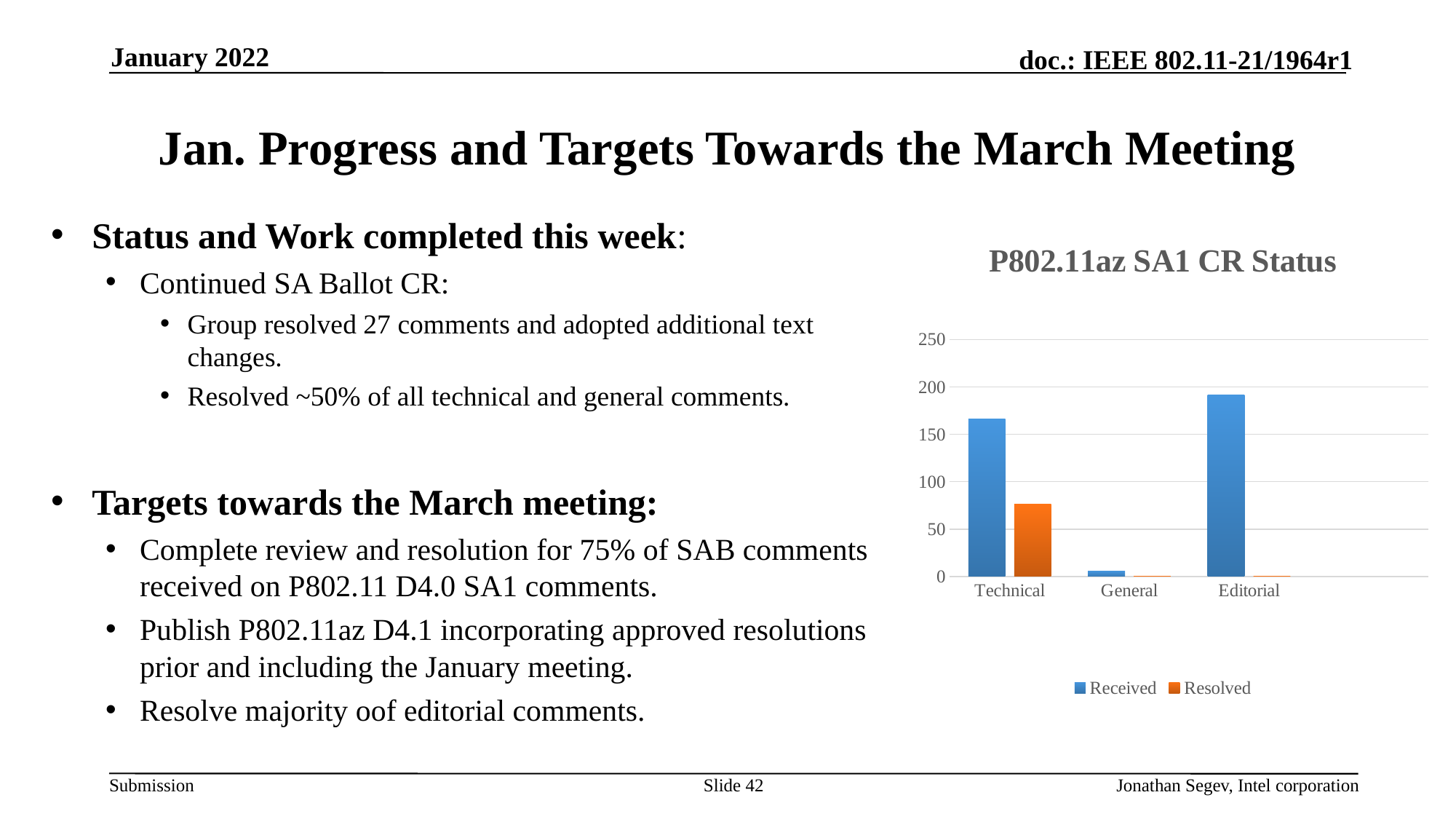
Is the Received value for Editorial greater or less than 200? less Is the Received value for General greater or less than 50? less Which category has the highest Received value? Editorial Is the Resolved value for Technical greater or less than 100? less Which series is shown in orange in the chart? Resolved Which is larger, the Received value for Editorial or the Received value for Technical? Editorial What type of chart is shown on the slide? bar chart How many series does the chart legend list? 2 Which category has the lowest Received value? General What is the title of the chart? P802.11az SA1 CR Status How many categories are shown on the x axis of the chart? 3